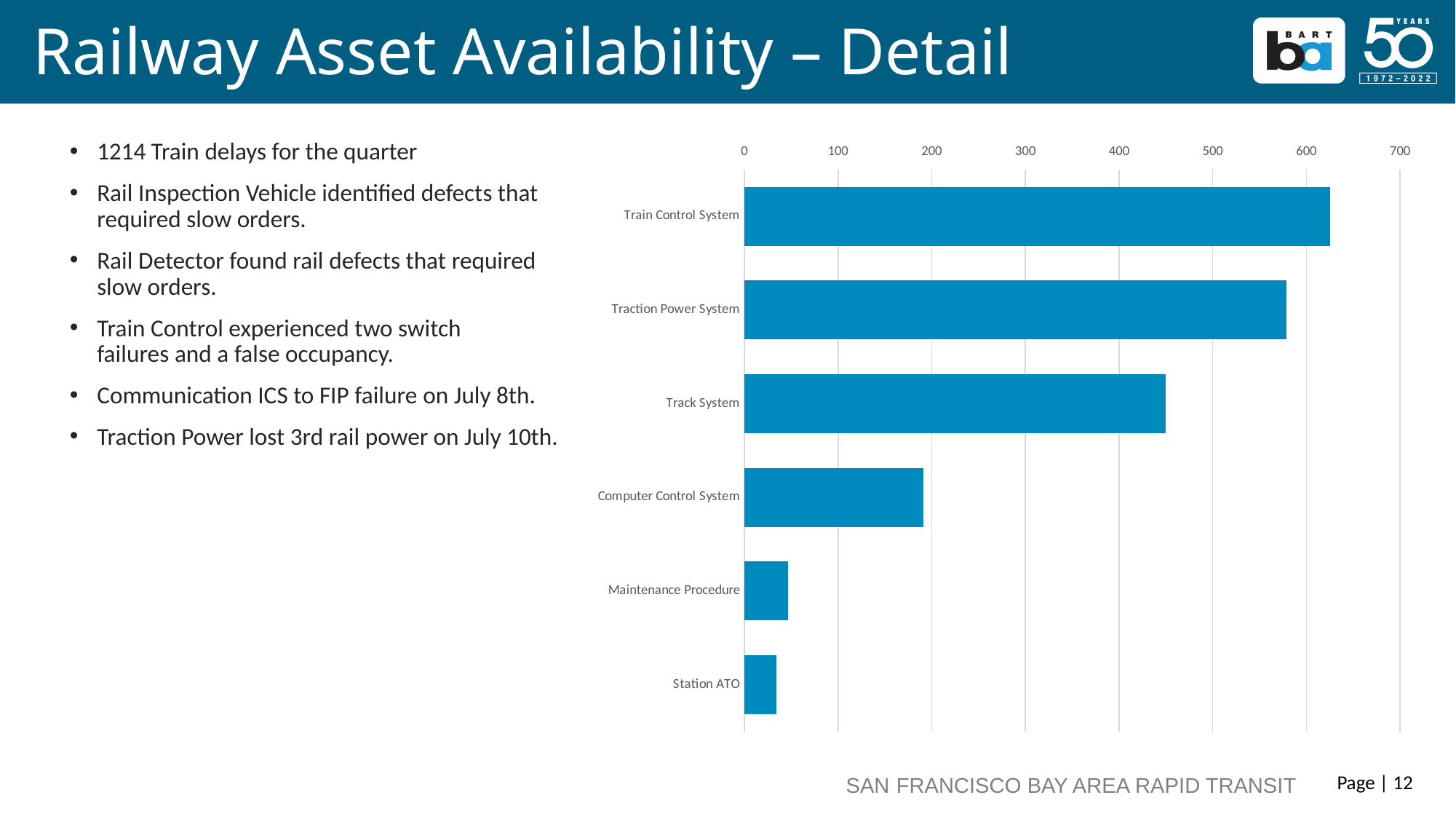
Which is larger, the value for Train Control System or the value for Traction Power System? Train Control System Is the value for Computer Control System greater or less than 100? greater Which category has the highest value in the bar chart? Train Control System Is the value for Track System greater or less than 500? less Is the value for Station ATO greater or less than 100? less Which is larger, the value for Track System or the value for Computer Control System? Track System What kind of chart is shown on the slide? bar chart How many categories are plotted in the bar chart? 6 What is the highest tick value shown on the chart's horizontal axis? 700